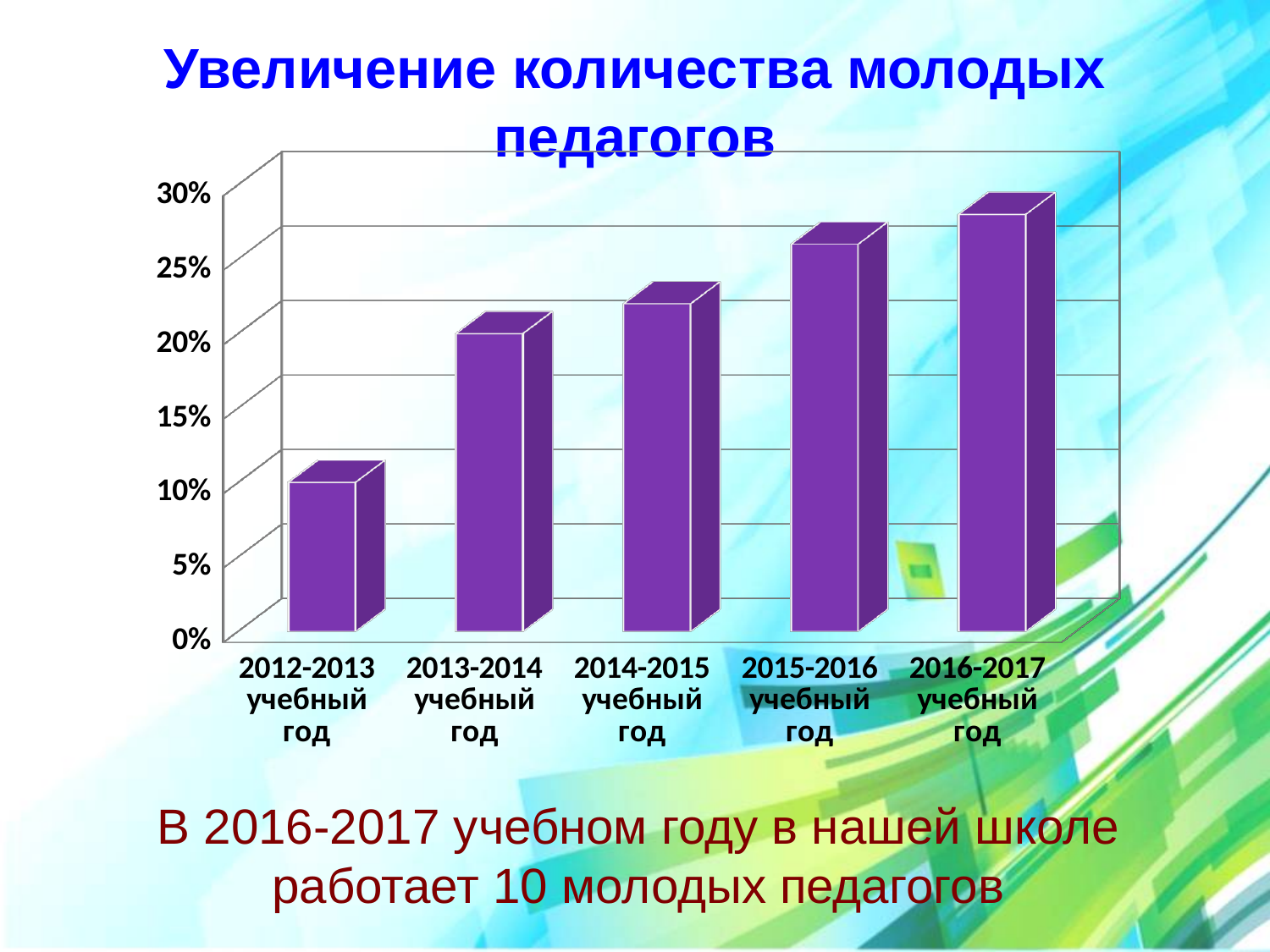
Do the values rise or fall from 2012-2013 to 2016-2017? rise Which academic year has the lowest bar? 2012-2013 учебный год What is the title of the chart? Увеличение количества молодых педагогов Is the value for 2013-2014 учебный год greater or less than 15%? greater Is the value for 2015-2016 учебный год greater or less than 25%? greater Is the value for 2012-2013 учебный год greater or less than 15%? less How many academic years (categories) are plotted on the chart? 5 Which is larger, the value for 2015-2016 учебный год or the value for 2013-2014 учебный год? 2015-2016 учебный год What colour are the bars in the chart? purple What kind of chart is shown on the slide? bar chart Which academic year has the highest bar? 2016-2017 учебный год